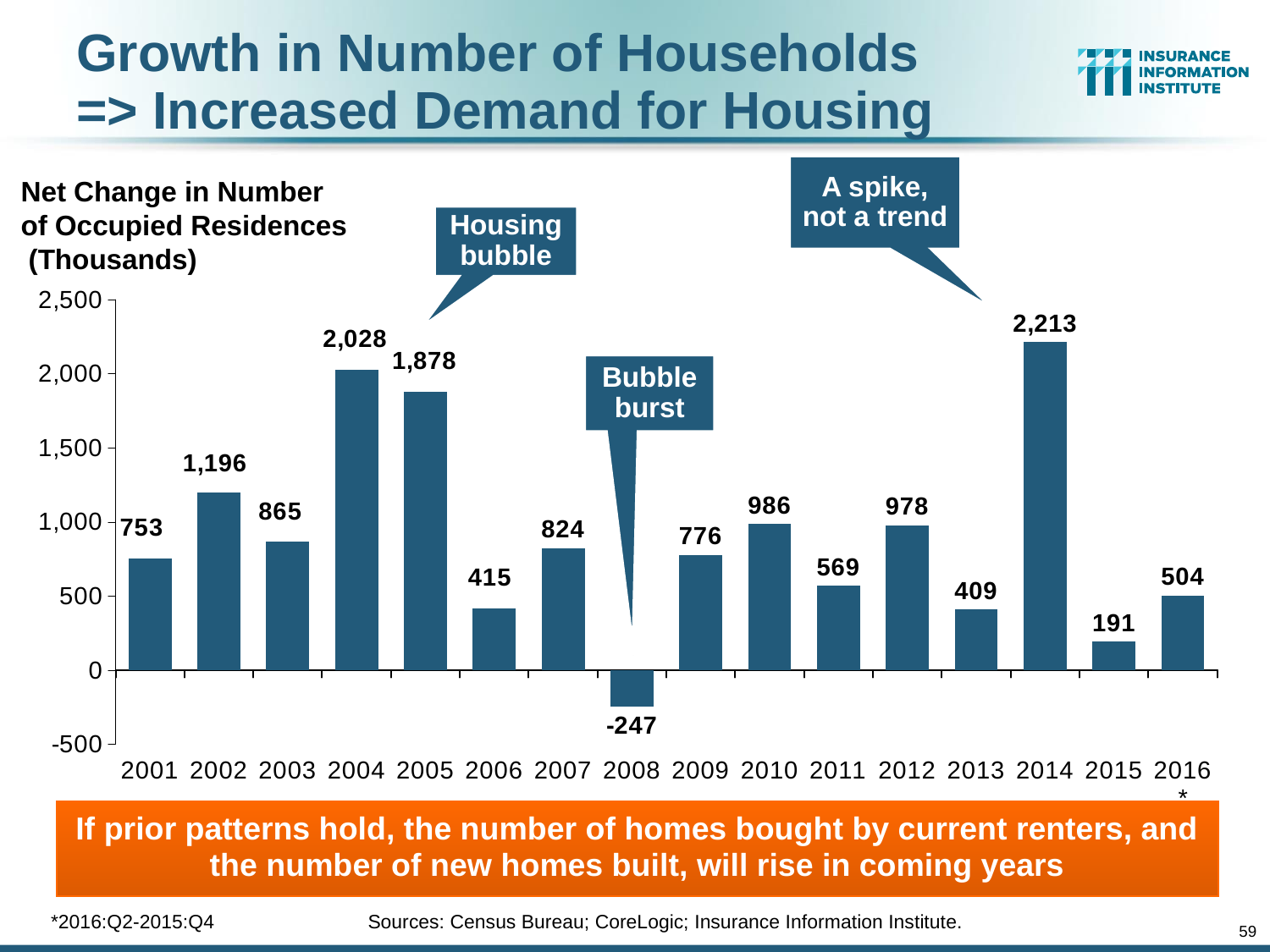
What is the value shown for 2015? 191 What does the callout pointing to the 2014 bar say? A spike, not a trend What is the value shown for 2008? -247 Which year has the larger value, 2010 or 2012? 2010 What kind of chart is shown on the slide? Bar chart What is the difference between the values for 2014 and 2015? 2,022 Which year has the lowest net change in number of occupied residences? 2008 What is the difference between the values for 2004 and 2005? 150 How many years are shown on the x axis? 16 Which year has the highest net change in number of occupied residences? 2014 What is the net change in number of occupied residences for 2004? 2,028 Is the value for 2002 greater or less than 1,000? greater